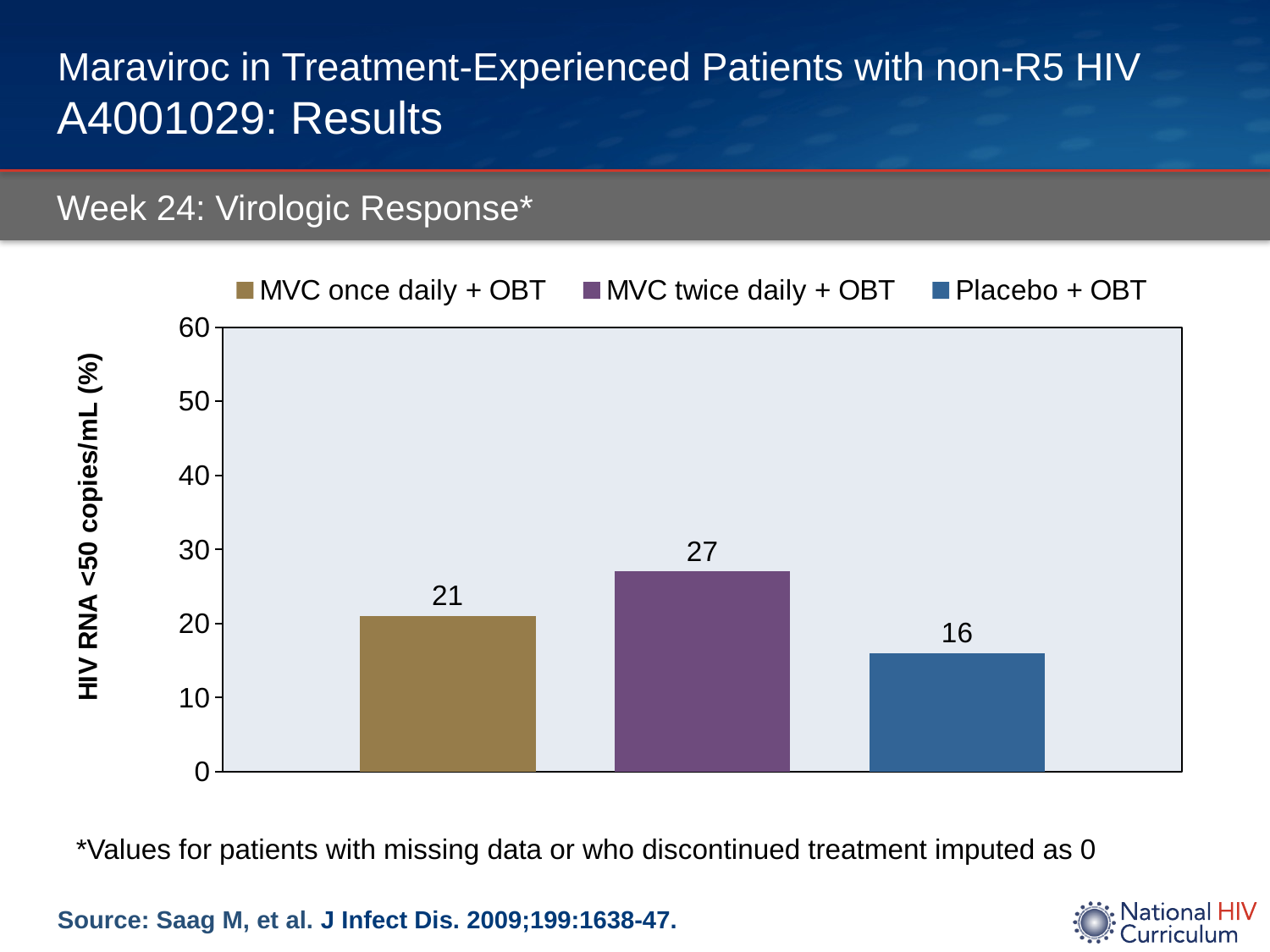
What is the difference between the values for MVC twice daily + OBT and Placebo + OBT? 11 What kind of chart is shown on the slide? Bar chart Which group has the lowest percentage of patients with HIV RNA <50 copies/mL? Placebo + OBT What is the value for MVC once daily + OBT? 21 What is the value for MVC twice daily + OBT? 27 How many series does the legend list? 3 What is the difference between the values for MVC twice daily + OBT and MVC once daily + OBT? 6 Which is larger, the value for MVC once daily + OBT or Placebo + OBT? MVC once daily + OBT What is the value for Placebo + OBT? 16 Is the value for MVC twice daily + OBT greater or less than 30? less Which group has the highest percentage of patients with HIV RNA <50 copies/mL? MVC twice daily + OBT What is the label of the y axis? HIV RNA <50 copies/mL (%)